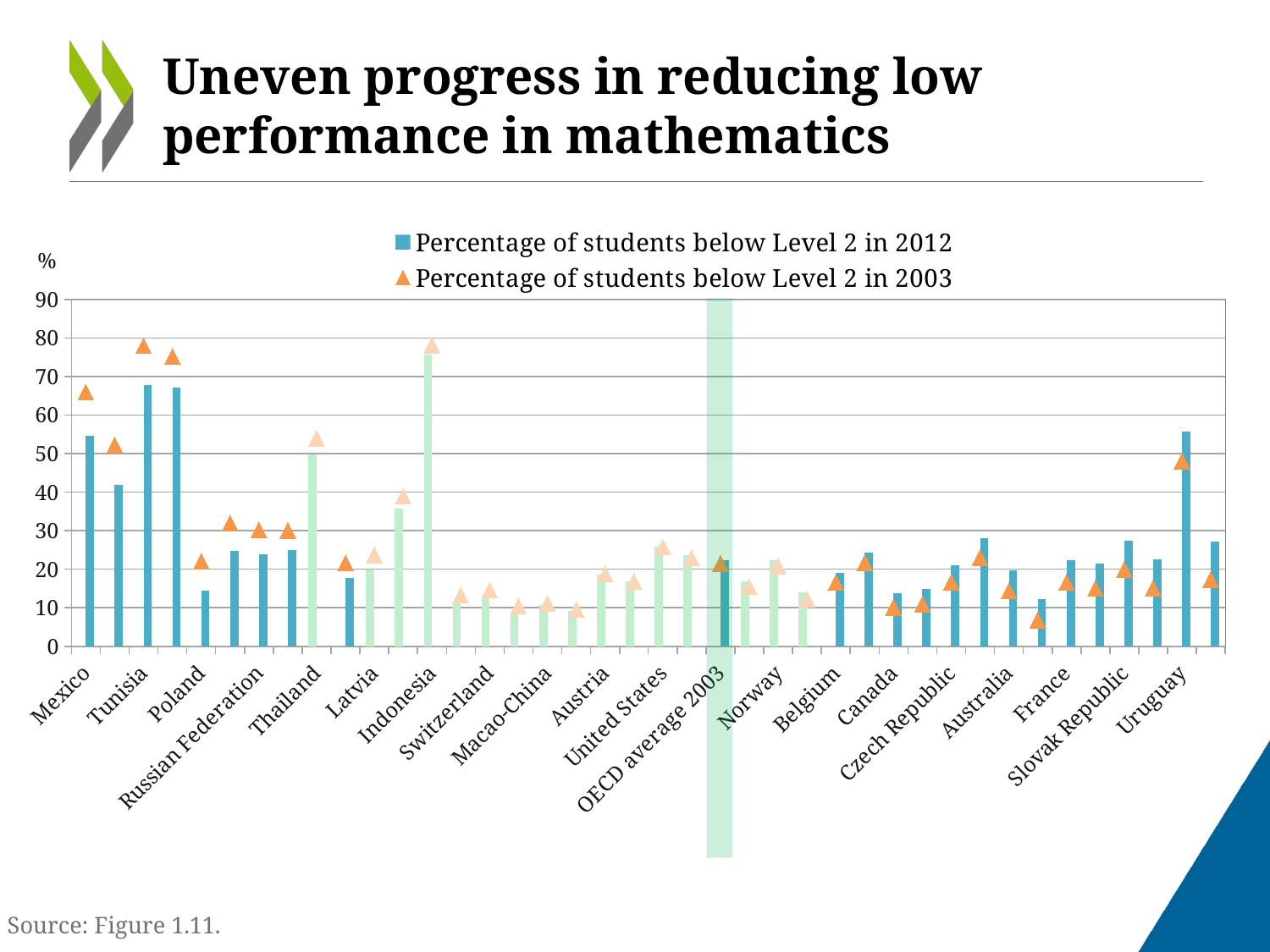
What is the title of the slide containing the chart? Uneven progress in reducing low performance in mathematics Which has a higher percentage of students below Level 2 in 2012, Mexico or Poland? Mexico Which country has the highest percentage of students below Level 2 in 2012? Indonesia Is the percentage of students below Level 2 in 2012 for Switzerland greater or less than 20? less For Mexico, which is larger: the percentage of students below Level 2 in 2003 or in 2012? 2003 Is the percentage of students below Level 2 in 2012 for Poland greater or less than 20? less Is the percentage of students below Level 2 in 2012 for Indonesia greater or less than 70? greater Which has a higher percentage of students below Level 2 in 2012, Indonesia or Uruguay? Indonesia How many series does the legend list? 2 What kind of chart is shown on the slide? bar chart